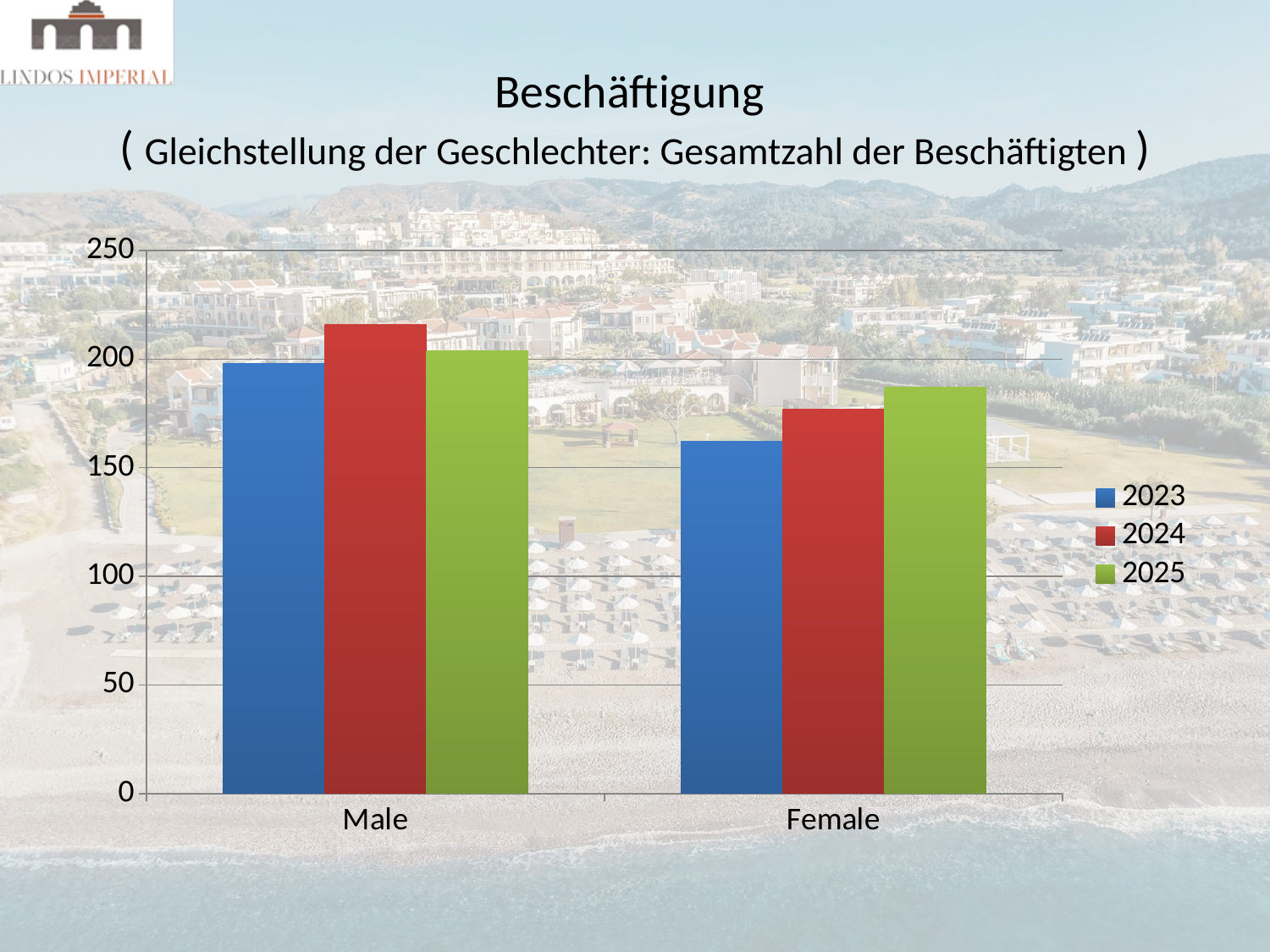
Is the value for Male in 2024 greater or less than 200? greater Which bar is the lowest in the whole chart? Female 2023 Which is larger: the value for Male in 2025 or the value for Female in 2025? Male in 2025 How many series does the legend list? 3 Which colour represents the 2025 series in the legend? green Is the value for Female in 2025 greater or less than 200? less Is the value for Female in 2023 greater or less than 150? greater What kind of chart is shown on the slide? bar chart Which year has the highest value for Male? 2024 Which is larger: the value for Female in 2023 or the value for Female in 2025? Female in 2025 Which year has the lowest value for Female? 2023 How many categories are shown on the x axis? 2